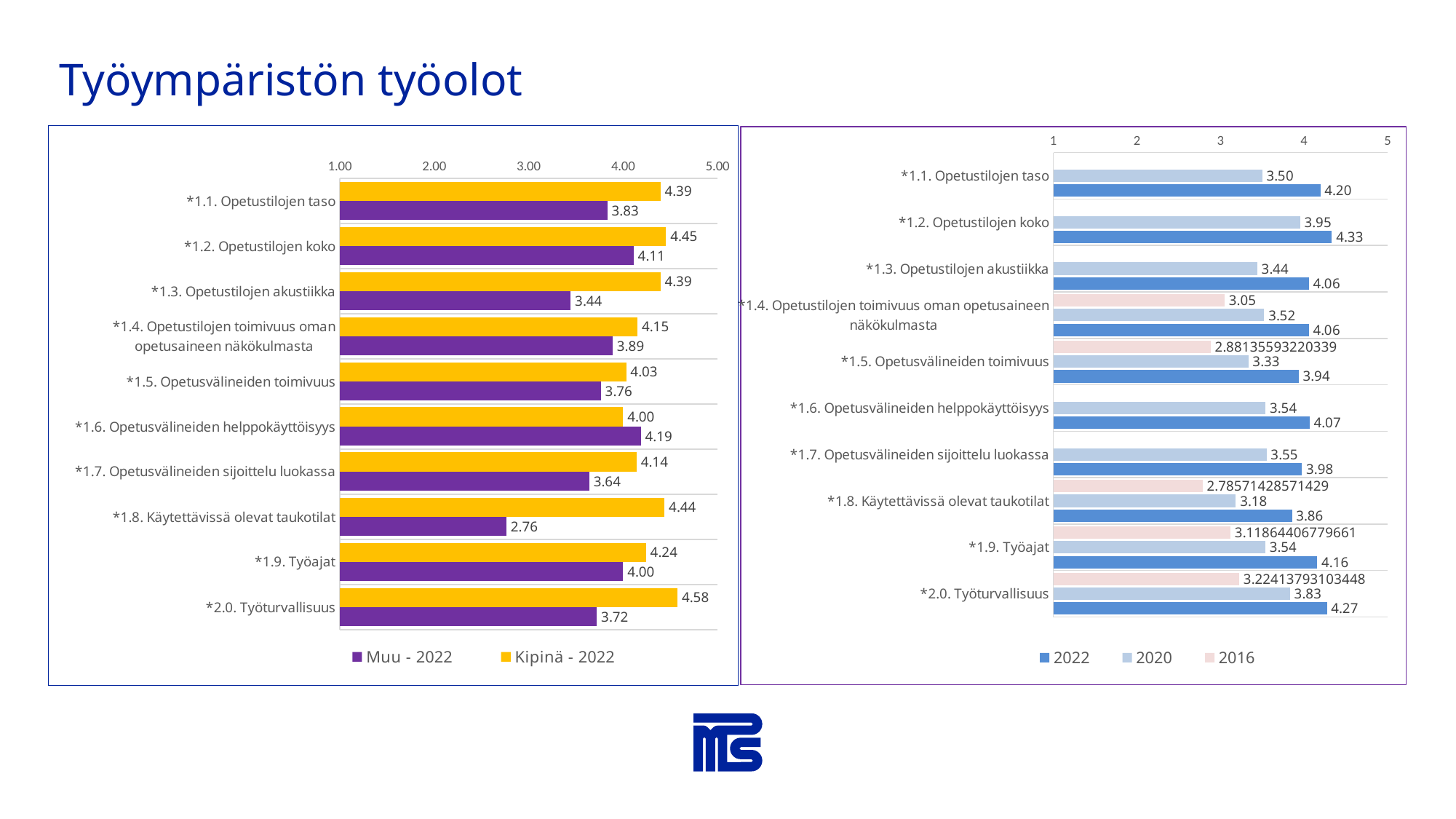
In the left chart, which category has the highest Kipinä - 2022 value? *2.0. Työturvallisuus In the left chart, what is the Kipinä - 2022 value for *1.8. Käytettävissä olevat taukotilat? 4.44 In the left chart, what is the Muu - 2022 value for *1.3. Opetustilojen akustiikka? 3.44 What kind of chart is the right chart? bar chart In the left chart, which category has the lowest Muu - 2022 value? *1.8. Käytettävissä olevat taukotilat How many categories are shown in the left chart? 10 How many series does the legend of the right chart list? 3 In the left chart, for *1.6. Opetusvälineiden helppokäyttöisyys, which series has the larger value, Muu - 2022 or Kipinä - 2022? Muu - 2022 In the right chart, what is the difference between the 2022 and 2020 values for *1.1. Opetustilojen taso? 0.70 In the left chart, what is the difference between the Kipinä - 2022 and Muu - 2022 values for *1.8. Käytettävissä olevat taukotilat? 1.68 How many series does the legend of the left chart list? 2 In the right chart, what is the 2022 value for *1.2. Opetustilojen koko? 4.33